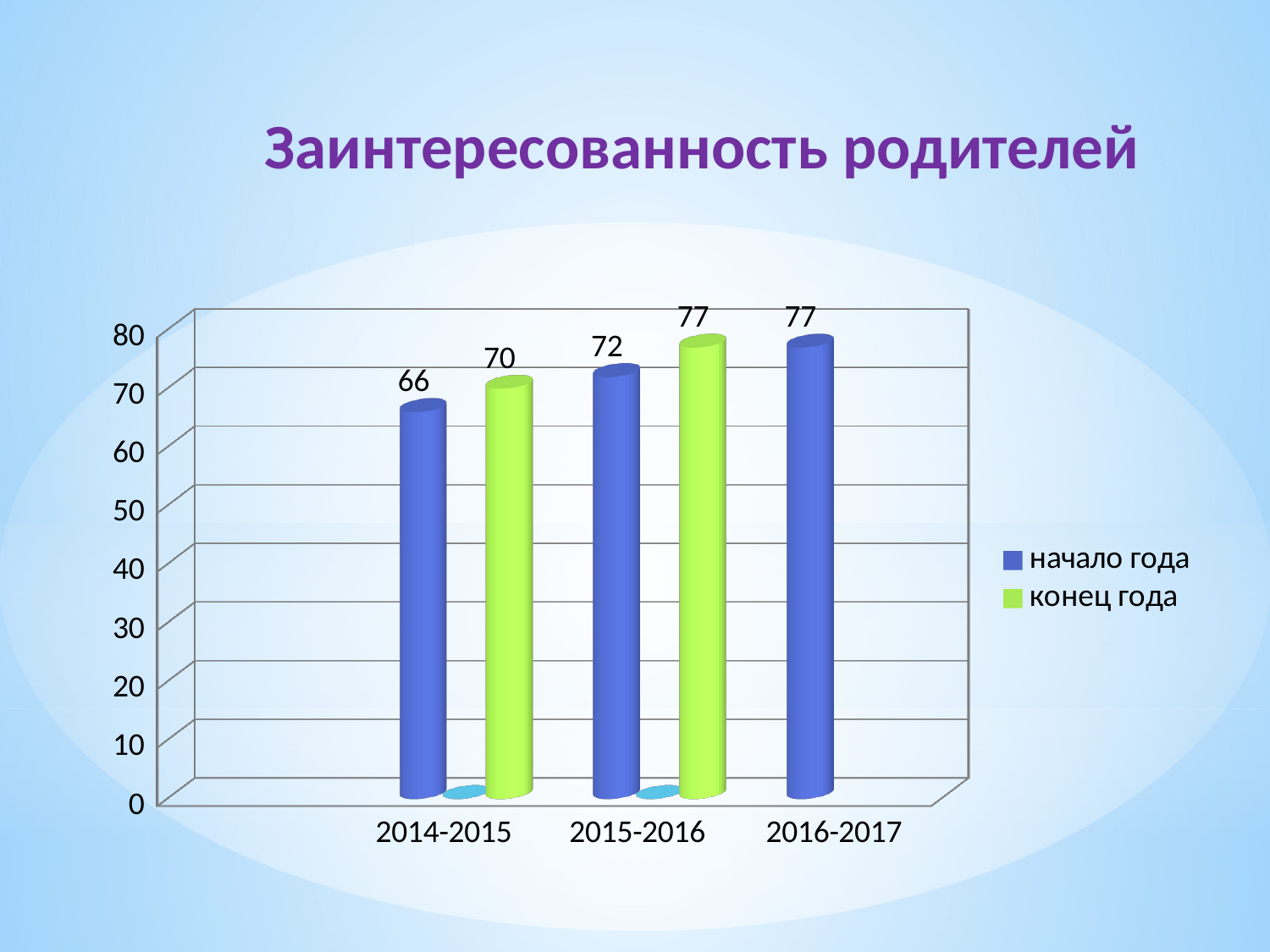
What is the value for "начало года" in 2014-2015? 66 What is the difference between "начало года" in 2016-2017 and in 2014-2015? 11 Which is larger in 2014-2015: "начало года" or "конец года"? конец года How many series does the legend list? 2 Do the "начало года" values rise or fall from 2014-2015 to 2016-2017? rise Which year has the highest value for "начало года"? 2016-2017 What is the value for "конец года" in 2014-2015? 70 What is the difference between "конец года" and "начало года" in 2015-2016? 5 What is the value for "конец года" in 2015-2016? 77 What kind of chart is shown on the slide? bar chart What is the value for "начало года" in 2016-2017? 77 Which year has the lowest value for "начало года"? 2014-2015